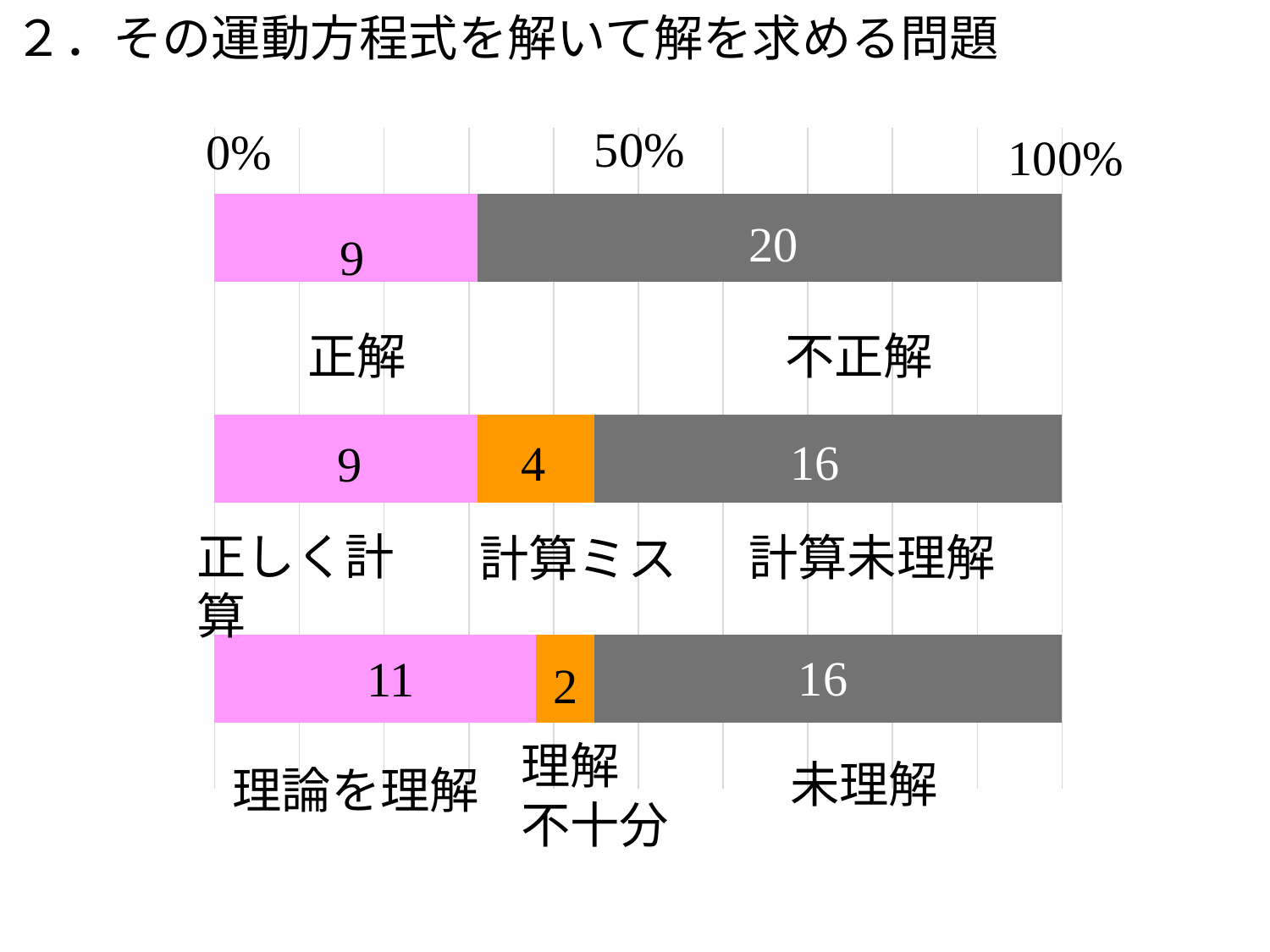
What is the difference between the 不正解 value and the 正解 value in the top bar? 11 How many bars are plotted in the chart? 3 What is the title of the slide above the chart? ２．その運動方程式を解いて解を求める問題 Which segment in the middle bar has the smallest value? 計算ミス What is the total of the segments in the middle bar (正しく計算, 計算ミス, 計算未理解)? 29 What is the value labelled 理解不十分 in the bottom bar? 2 What is the value labelled 計算ミス in the middle bar? 4 What type of chart is shown on the slide? stacked bar chart What is the value labelled 不正解 in the top bar? 20 Which is larger in the bottom bar, 理論を理解 or 未理解? 未理解 What is the value labelled 理論を理解 in the bottom bar? 11 What is the value labelled 正解 in the top bar? 9